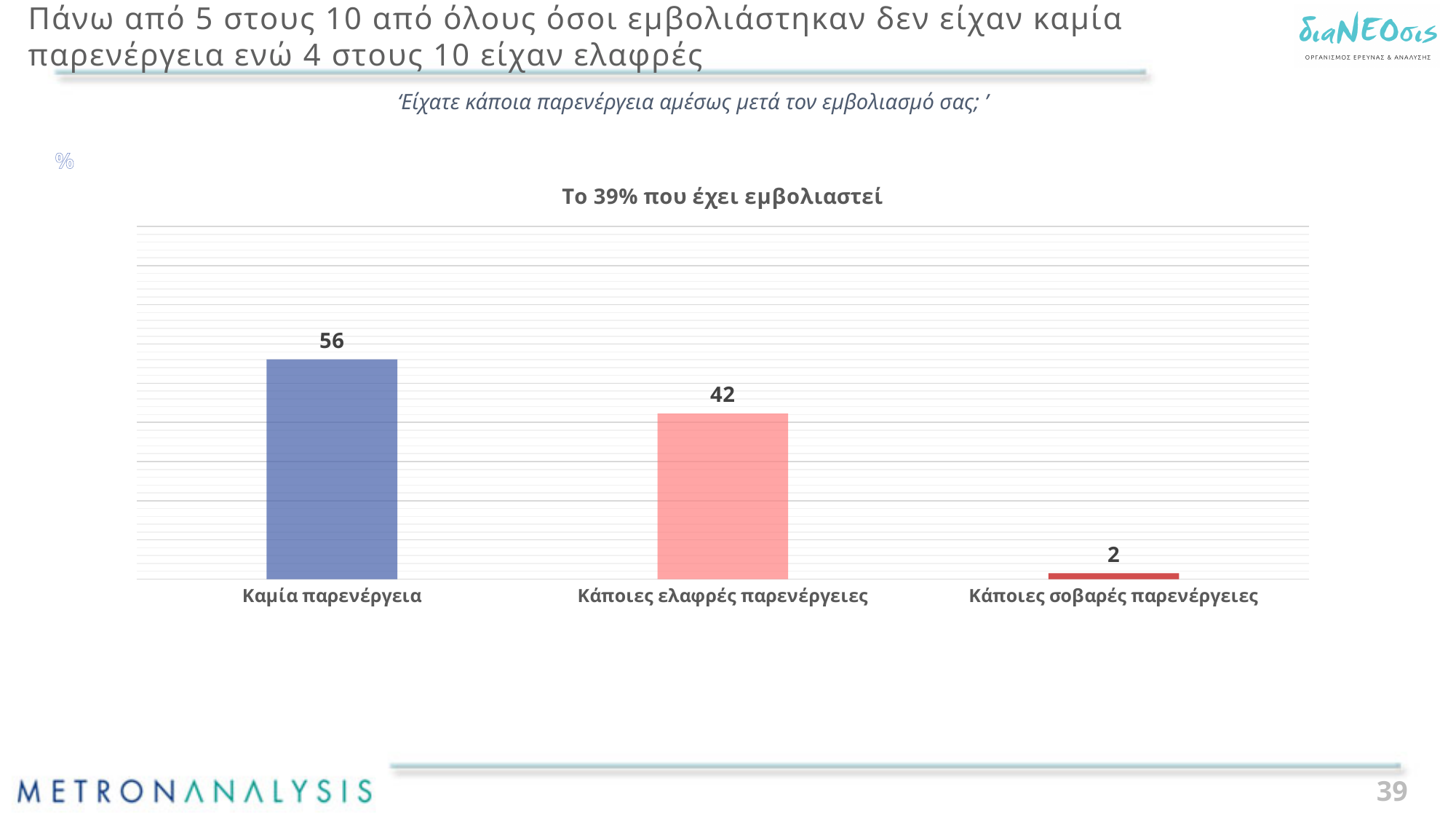
Which category has the highest value? Καμία παρενέργεια What is the value for 'Κάποιες σοβαρές παρενέργειες'? 2 What is the value for 'Κάποιες ελαφρές παρενέργειες'? 42 What colour is the bar for 'Κάποιες ελαφρές παρενέργειες'? Pink What is the difference between the values for 'Κάποιες ελαφρές παρενέργειες' and 'Κάποιες σοβαρές παρενέργειες'? 40 What is the difference between the values for 'Καμία παρενέργεια' and 'Κάποιες ελαφρές παρενέργειες'? 14 What is the value for 'Καμία παρενέργεια'? 56 Which is larger: the value for 'Καμία παρενέργεια' or for 'Κάποιες ελαφρές παρενέργειες'? Καμία παρενέργεια What is the title of the chart? Το 39% που έχει εμβολιαστεί Which category has the lowest value? Κάποιες σοβαρές παρενέργειες What kind of chart is shown on the slide? Bar chart How many categories are shown in the chart? 3